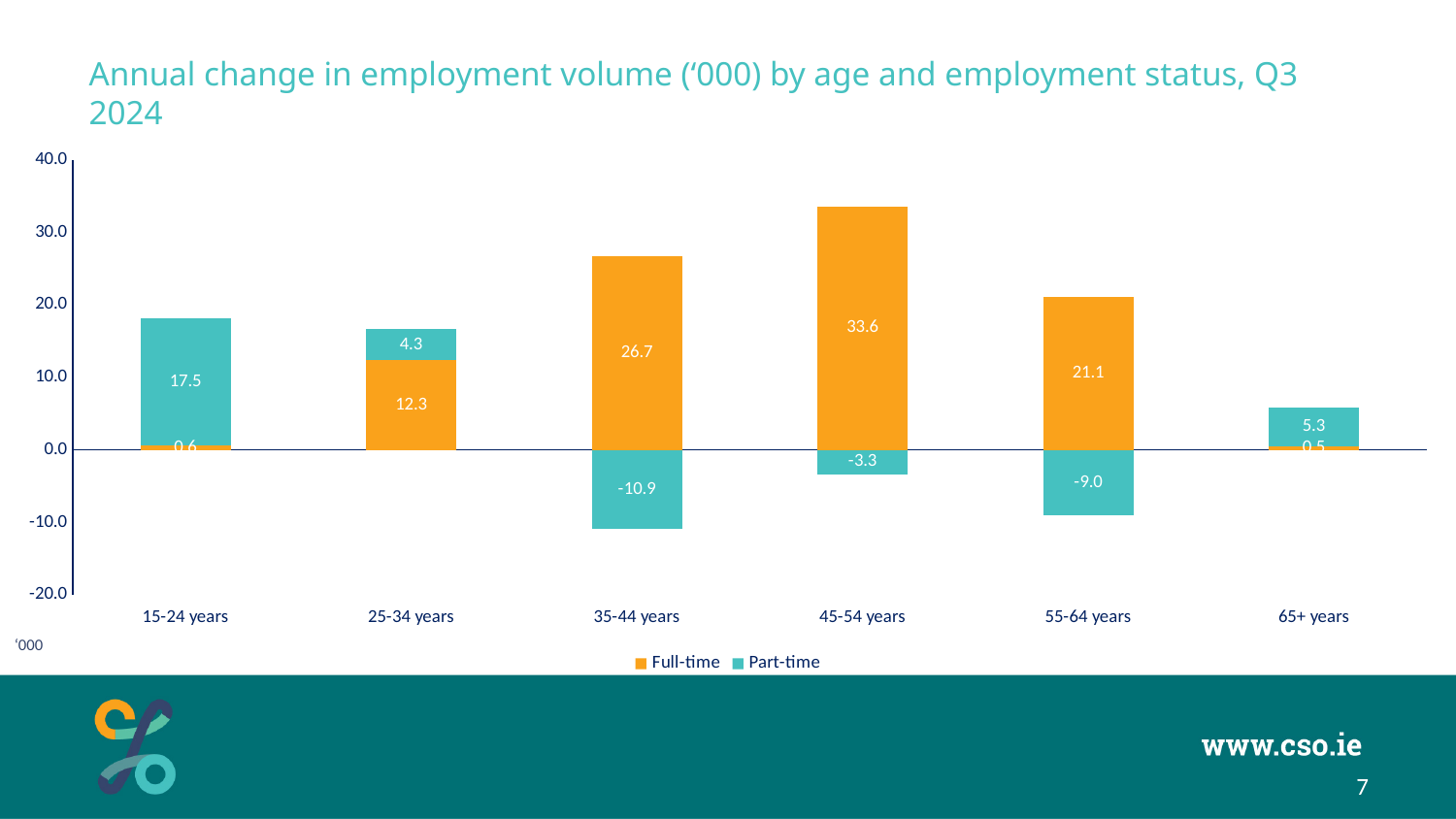
What is the Full-time value for 45-54 years? 33.6 Which age group has the highest Full-time value? 45-54 years What is the Part-time value for 35-44 years? -10.9 How many series does the legend list? 2 What is the total of the stacked bar for 25-34 years? 16.6 How many age groups are shown on the x axis? 6 What kind of chart is shown on the slide? Stacked bar chart What is the Part-time value for 15-24 years? 17.5 What is the Full-time value for 55-64 years? 21.1 Which is larger, the Full-time value for 25-34 years or for 55-64 years? 55-64 years Which age group has the lowest Part-time value? 35-44 years What is the difference between the Full-time values for 45-54 years and 35-44 years? 6.9